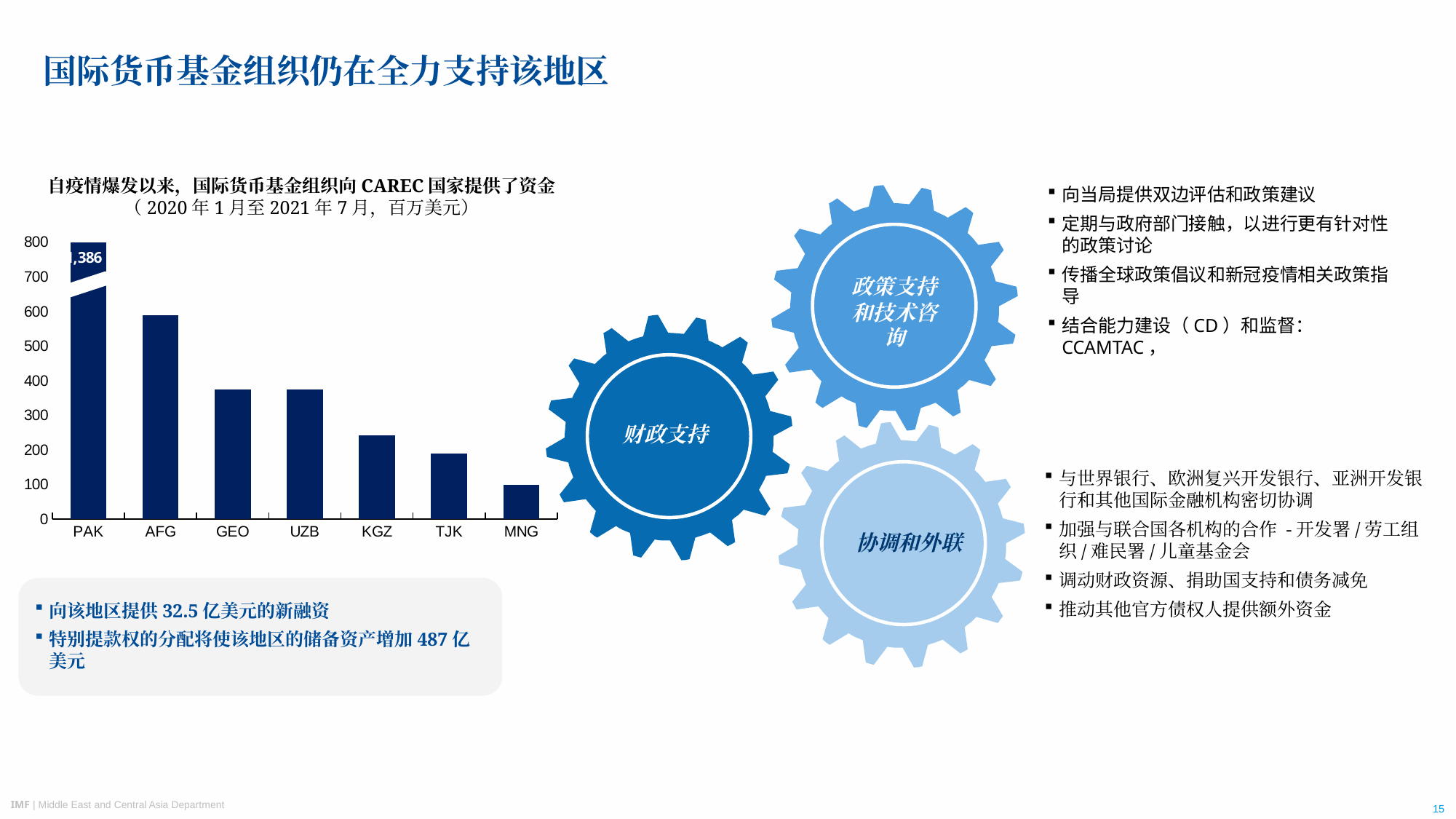
Which country has the lowest bar in the chart? MNG Is the value for TJK greater or less than 100? greater Is the value for KGZ greater or less than 300? less Which has a larger value, AFG or GEO? AFG Which has a larger value, KGZ or TJK? KGZ Is the value for MNG greater or less than 200? less What unit is stated in the chart subtitle for the values? 百万美元 What kind of chart is shown on the slide? bar chart Do the bar values rise or fall from left to right along the x axis? fall How many countries are shown on the x axis of the bar chart? 7 Which country has the highest bar in the chart? PAK